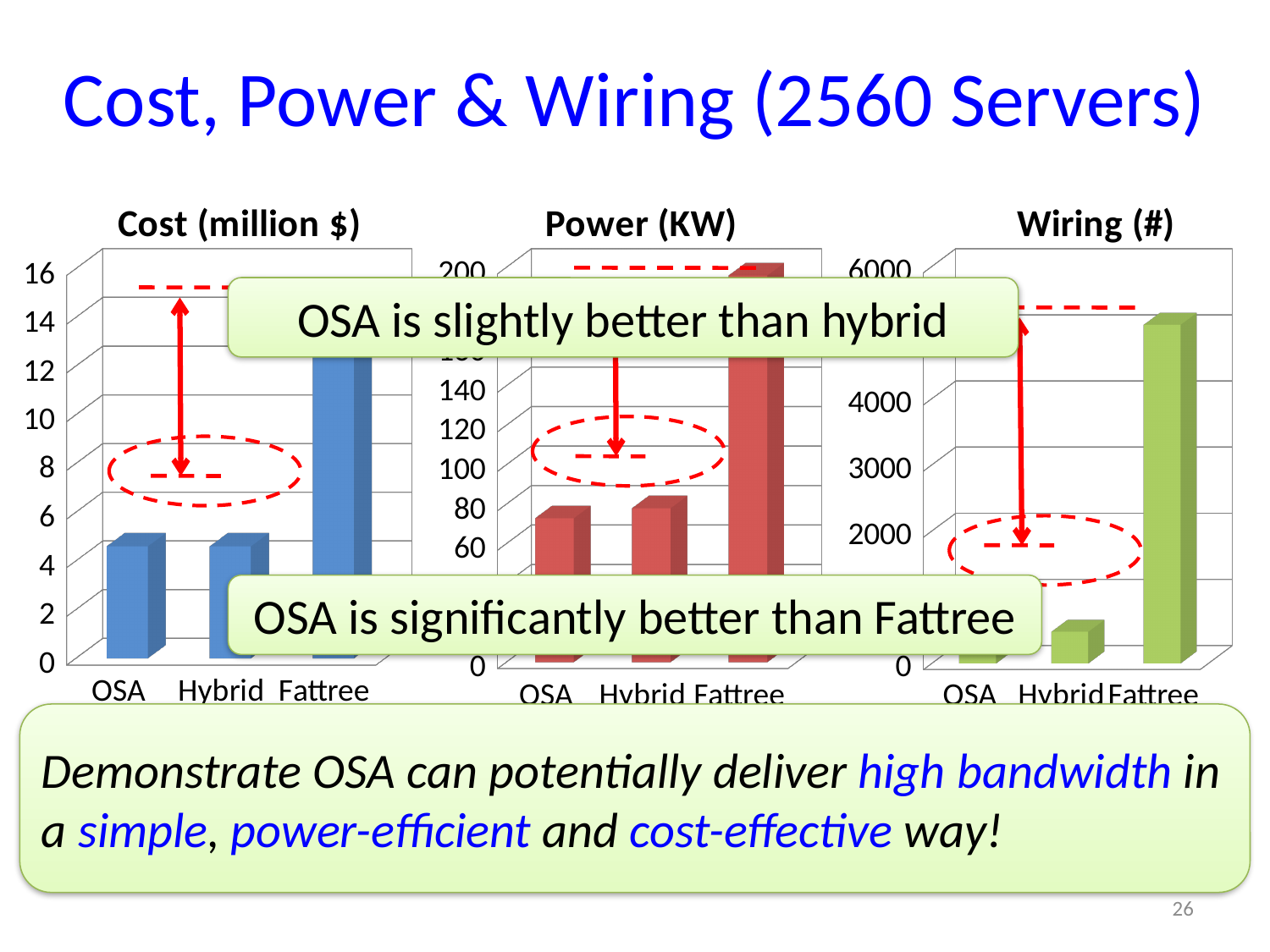
How many charts are shown on the slide? 3 In the Wiring (#) chart, which is larger, the value for Hybrid or the value for Fattree? Fattree In the Cost (million $) chart, is the value for Fattree greater or less than 10? greater What kind of chart is the Cost (million $) chart? bar chart In the Cost (million $) chart, is the value for OSA greater or less than 8? less In the Power (KW) chart, is the value for OSA greater or less than 100? less In the Power (KW) chart, which category has the highest value? Fattree How many categories are shown on the Power (KW) chart? 3 In the Cost (million $) chart, which category has the highest value? Fattree In the Wiring (#) chart, which category has the lowest value? OSA